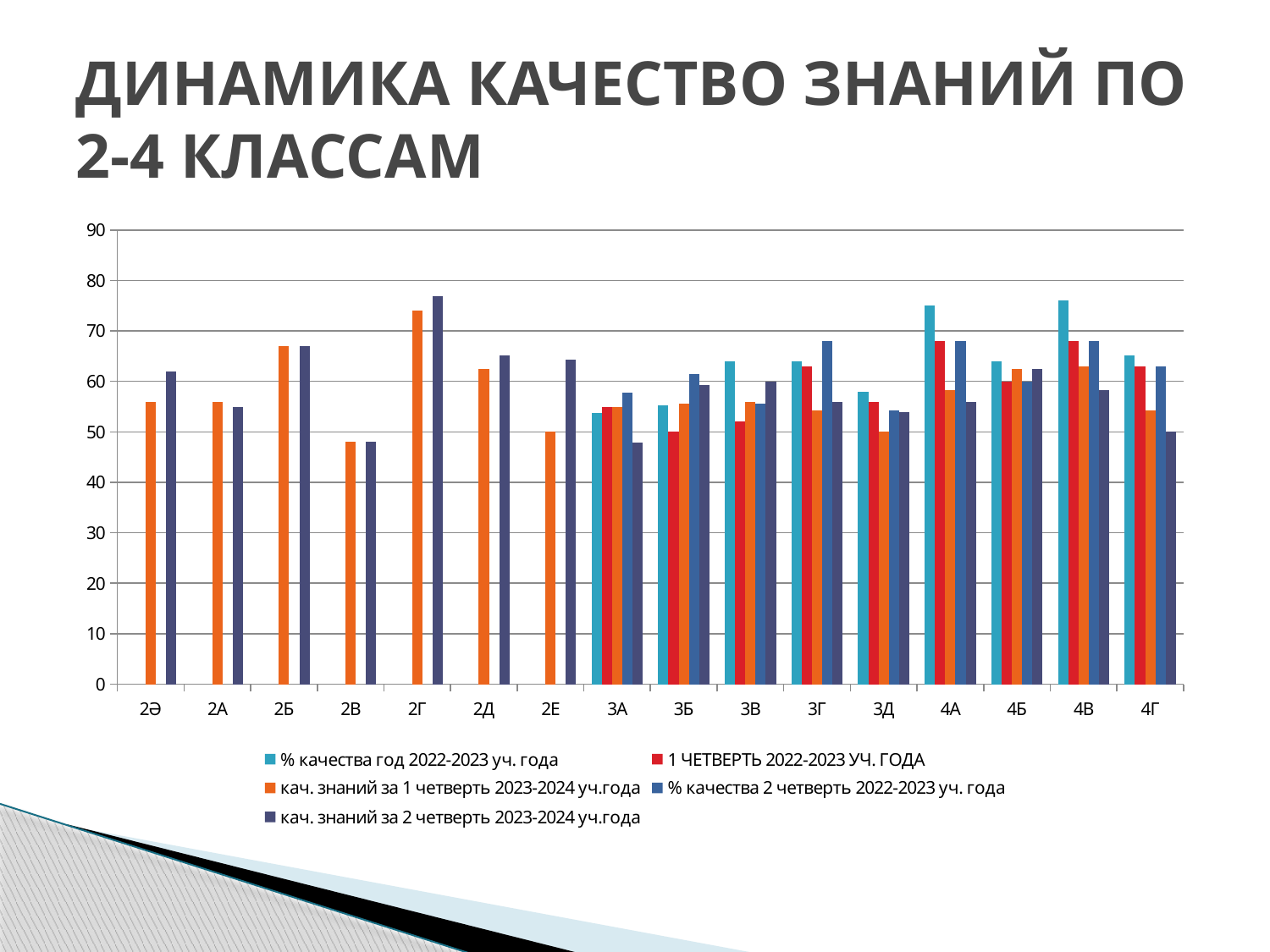
In the series 'кач. знаний за 1 четверть 2023-2024 уч.года', which is larger: 2Б or 2А? 2Б Which class has the highest value in the series 'кач. знаний за 2 четверть 2023-2024 уч.года'? 2Г Is the value for 2Г in the series 'кач. знаний за 1 четверть 2023-2024 уч.года' greater or less than 70? greater Is the value for 4В in the series '% качества год 2022-2023 уч. года' greater or less than 70? greater How many classes (categories) are shown along the x axis? 16 In the series '% качества год 2022-2023 уч. года', which is larger: 4А or 3А? 4А How many series does the legend list? 5 What kind of chart is shown on the slide? bar chart What is the title of the slide? ДИНАМИКА КАЧЕСТВО ЗНАНИЙ ПО 2-4 КЛАССАМ Which class has the highest value in the series 'кач. знаний за 1 четверть 2023-2024 уч.года'? 2Г Is the value for 2В in the series 'кач. знаний за 1 четверть 2023-2024 уч.года' greater or less than 50? less